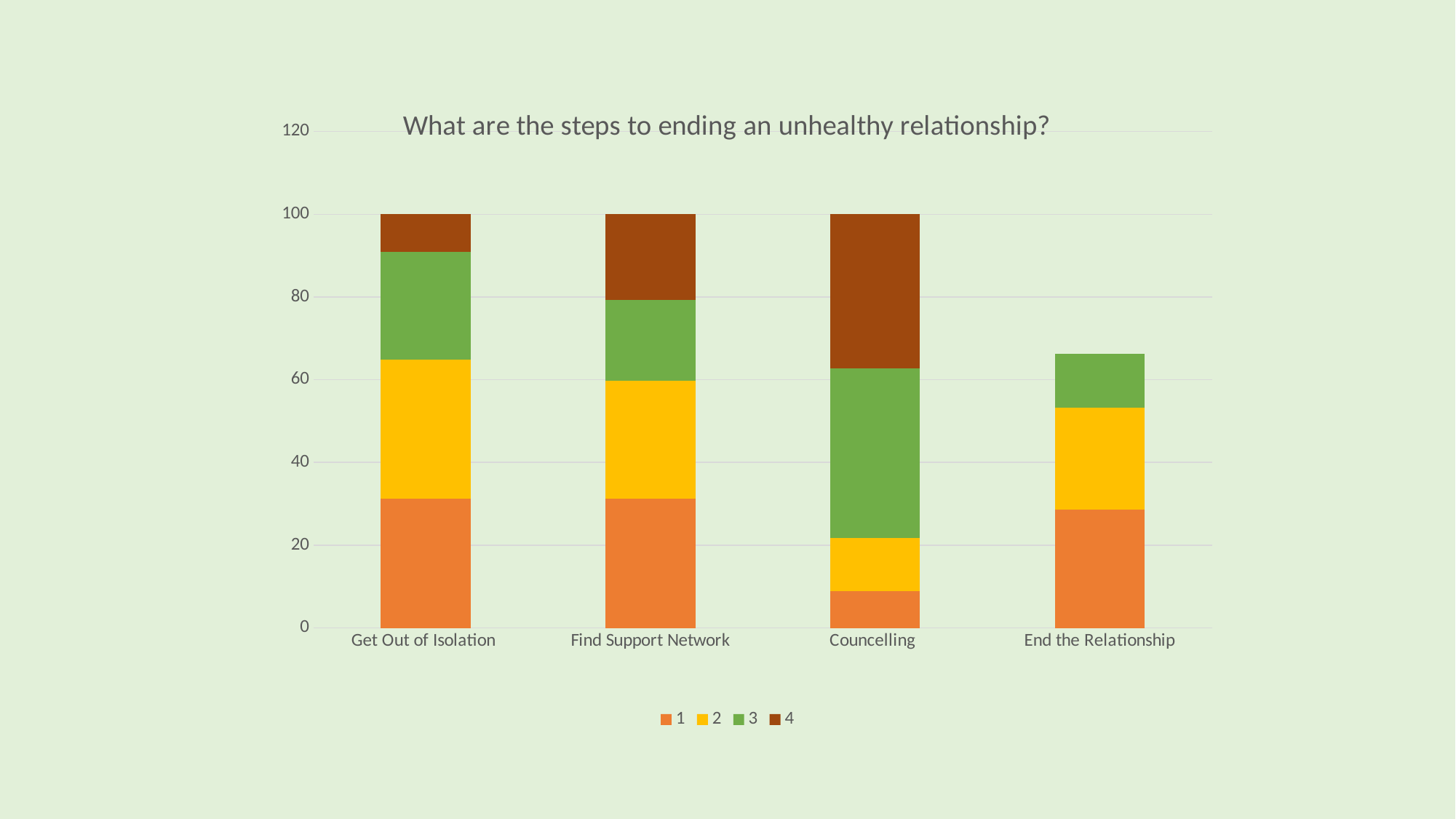
What is the total height of the stacked bar for Councelling? 100 Is the value of series 1 for Councelling greater or less than 20? less What is the title of the chart? What are the steps to ending an unhealthy relationship? Which category has the lowest total stacked bar? End the Relationship How many categories are shown on the x axis? 4 Is the value of series 1 for Get Out of Isolation greater or less than 20? greater What is the total height of the stacked bar for Get Out of Isolation? 100 Which has the larger total bar, Find Support Network or End the Relationship? Find Support Network Is the total for End the Relationship greater or less than 60? greater Which category has no segment for series 4? End the Relationship How many series does the legend list? 4 What kind of chart is shown on the slide? stacked bar chart